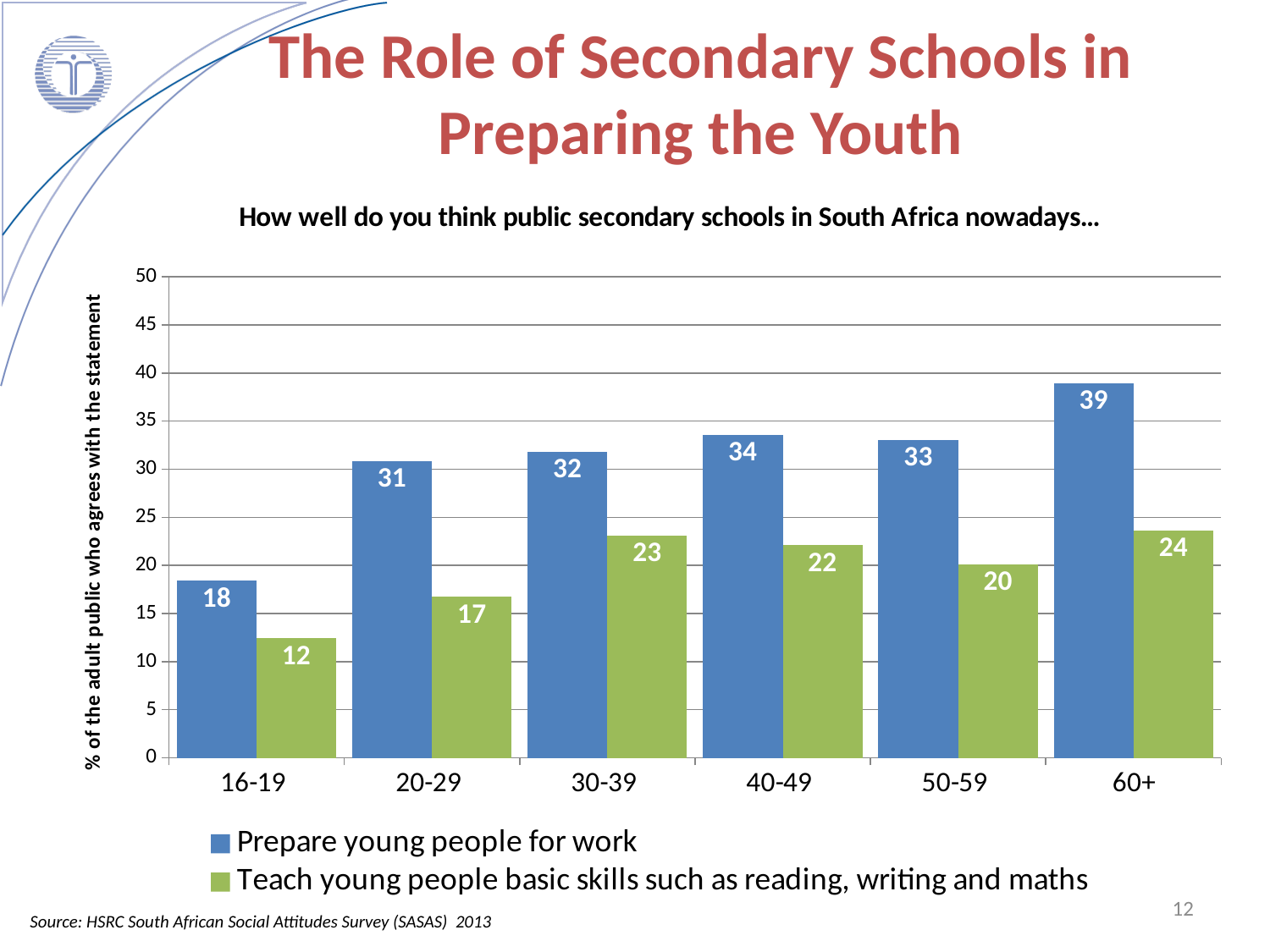
Which age group has the lowest value for 'Teach young people basic skills such as reading, writing and maths'? 16-19 How many age groups are shown on the x axis? 6 Is the value for 'Prepare young people for work' in the 50-59 age group greater or less than 30? greater What is the value for 'Teach young people basic skills such as reading, writing and maths' in the 16-19 age group? 12 Which age group has the highest value for 'Prepare young people for work'? 60+ How many series does the legend list? 2 What is the label of the y axis? % of the adult public who agrees with the statement What is the value for 'Prepare young people for work' in the 60+ age group? 39 What is the value for 'Prepare young people for work' in the 40-49 age group? 34 What kind of chart is shown on the slide? bar chart What is the difference between the two series in the 20-29 age group? 14 In the 30-39 age group, which series has the larger value? Prepare young people for work